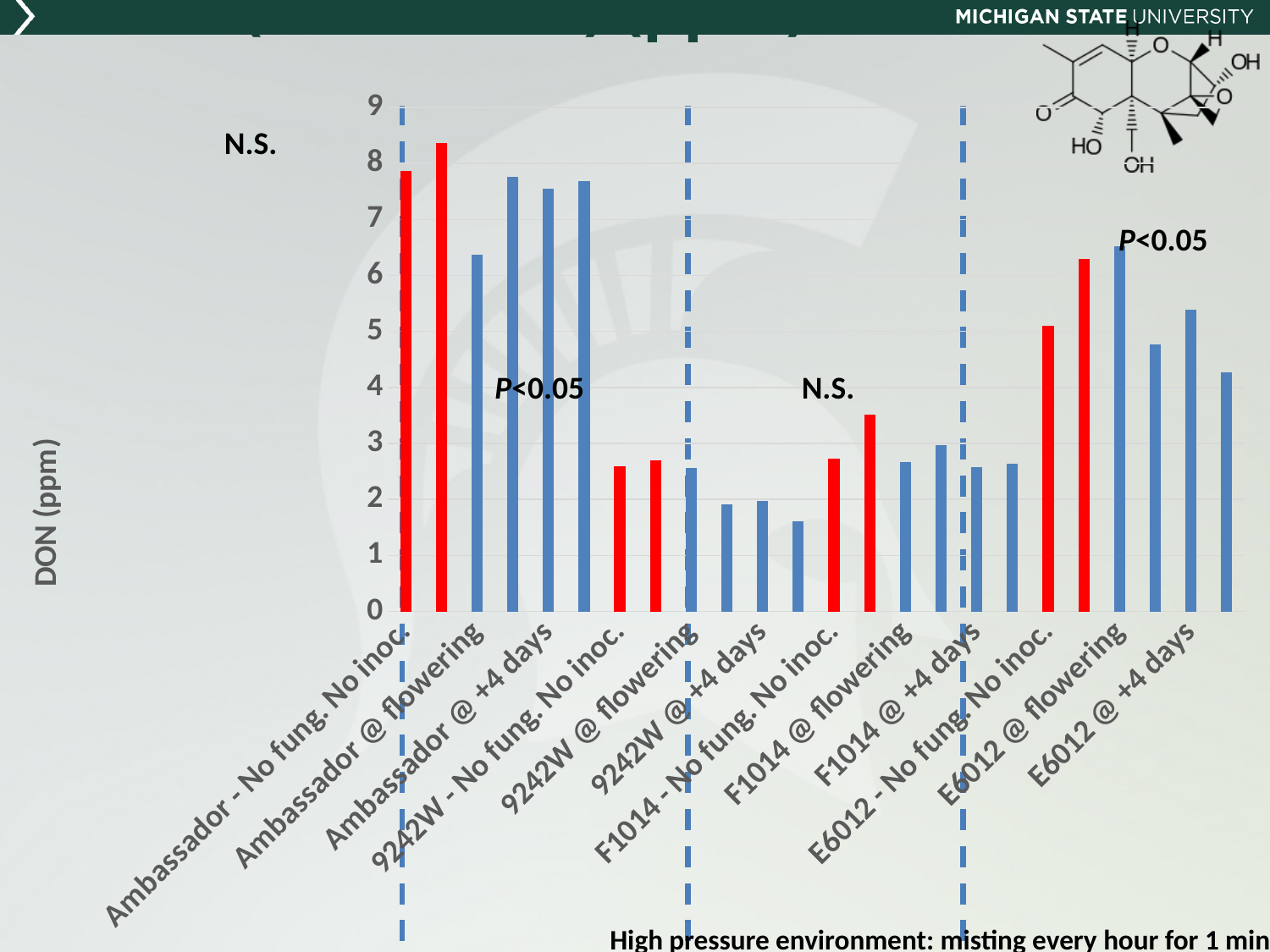
Are the bars for '9242W @ +4 days' greater or less than 3 ppm? less Which has higher DON values: 'Ambassador - No fung. No inoc.' or '9242W - No fung. No inoc.'? Ambassador - No fung. No inoc. What kind of chart is shown on the slide? bar chart Are the bars for 'F1014 @ flowering' greater or less than 4 ppm? less Are the bars for 'Ambassador - No fung. No inoc.' greater or less than 7 ppm? greater What is the highest tick value shown on the y-axis? 9 What is the label on the y-axis of the chart? DON (ppm) How many category labels are shown along the x-axis of the chart? 12